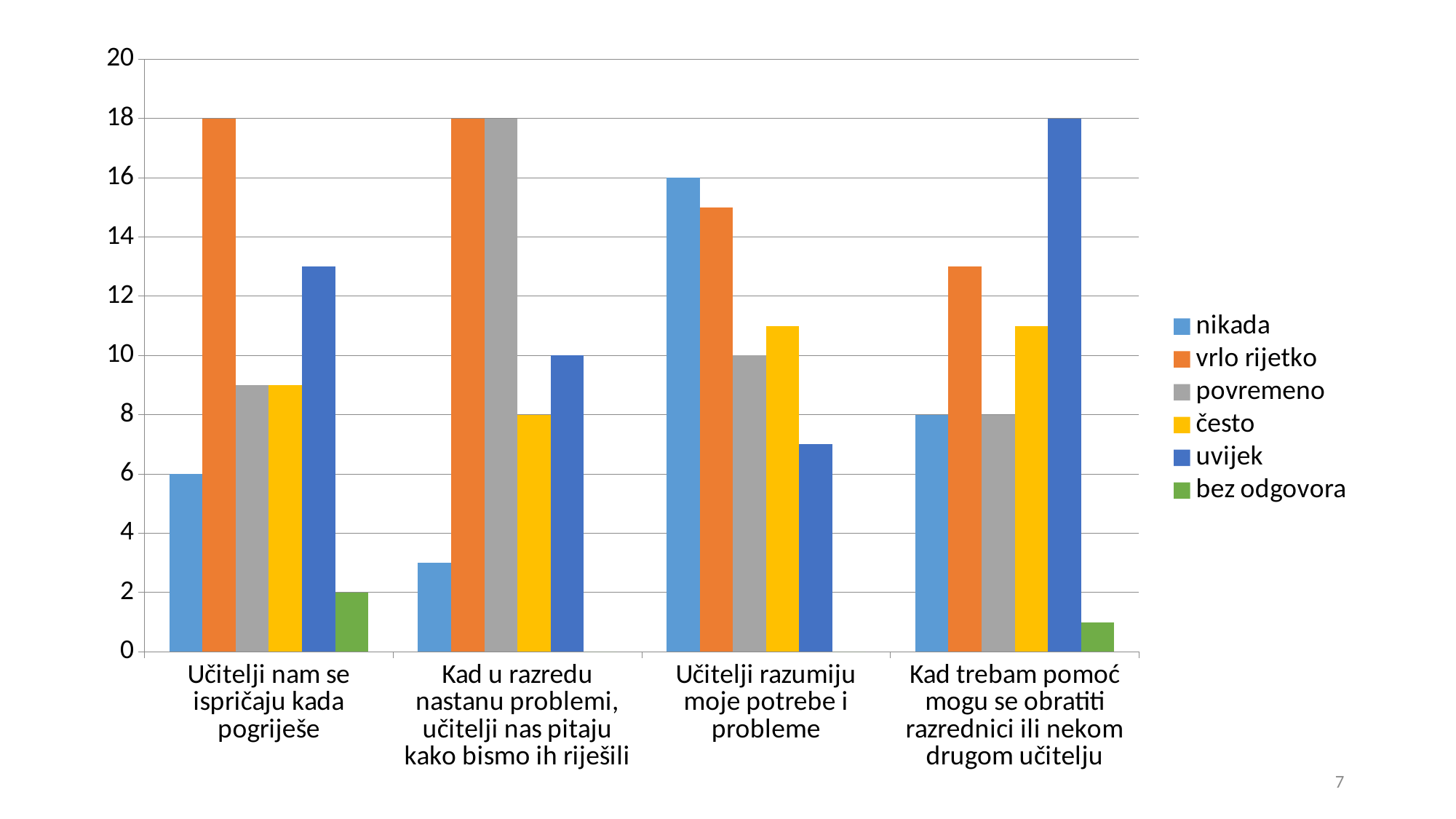
What is the value of "vrlo rijetko" for "Učitelji nam se ispričaju kada pogriješe"? 18 For "Kad u razredu nastanu problemi, učitelji nas pitaju kako bismo ih riješili", which is larger: "često" or "uvijek"? uvijek How many series does the legend list? 6 Is the value of "uvijek" for "Učitelji nam se ispričaju kada pogriješe" greater or less than 12? greater What is the value of "bez odgovora" for "Učitelji nam se ispričaju kada pogriješe"? 2 What is the difference between "nikada" and "povremeno" for "Učitelji razumiju moje potrebe i probleme"? 6 How many categories are shown on the x axis? 4 What is the value of "uvijek" for "Kad trebam pomoć mogu se obratiti razrednici ili nekom drugom učitelju"? 18 What is the value of "nikada" for "Učitelji razumiju moje potrebe i probleme"? 16 Which series has the highest value for "Učitelji razumiju moje potrebe i probleme"? nikada What kind of chart is shown on the slide? bar chart